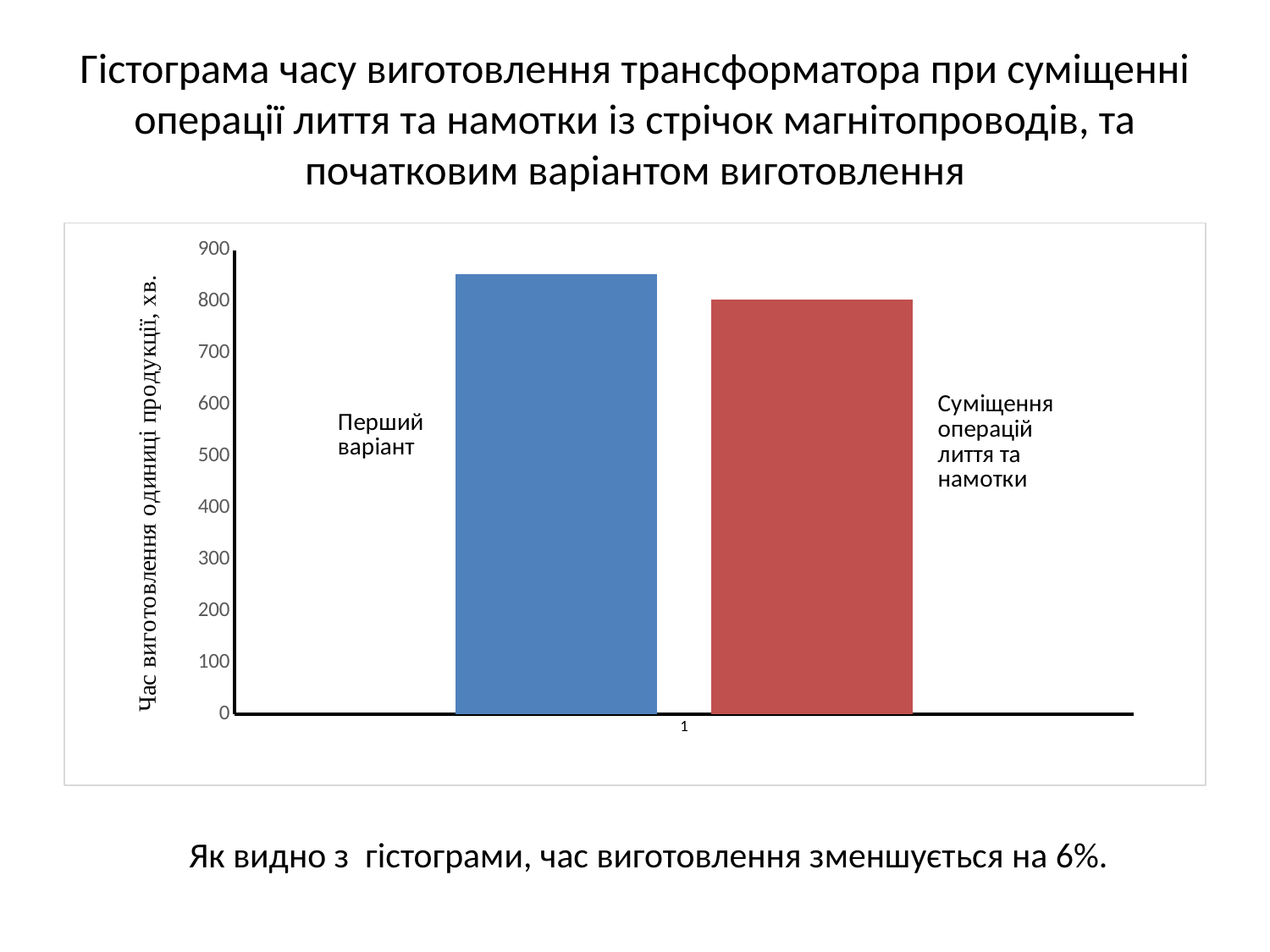
Is the value for "Перший варіант" greater or less than 800? greater Which bar has the lowest value? Суміщення операцій лиття та намотки What colour is the bar for "Перший варіант"? blue Is the value for "Суміщення операцій лиття та намотки" greater or less than 700? greater Is the value for "Перший варіант" greater or less than 900? less What is the label of the vertical axis? Час виготовлення одиниці продукції, хв. How many bars are plotted in the chart? 2 Which bar has the highest value? Перший варіант Which bar is taller, "Перший варіант" or "Суміщення операцій лиття та намотки"? Перший варіант What kind of chart is shown on the slide? bar chart